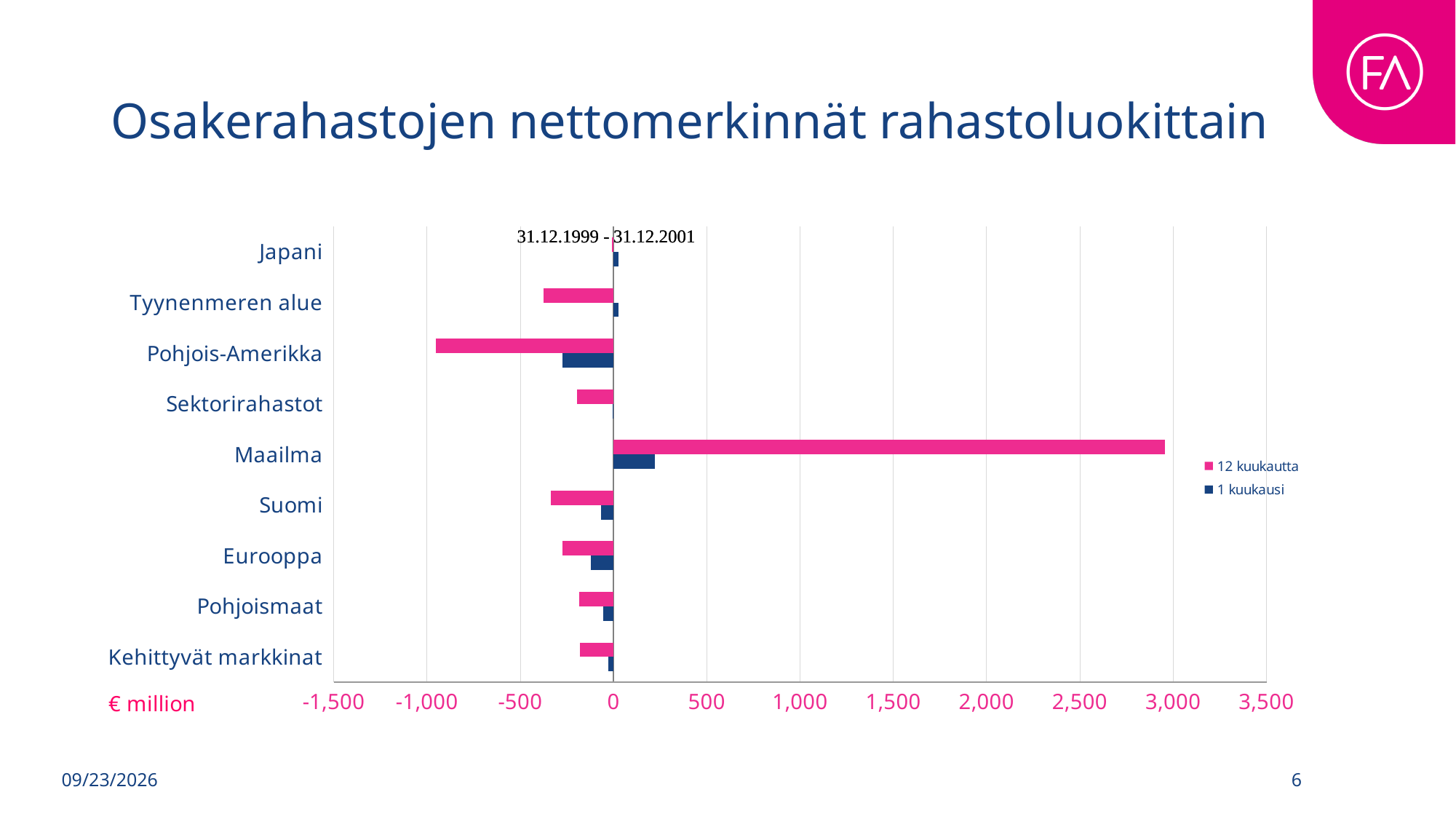
How many fund categories are listed on the vertical axis of the chart? 9 Which category has the lowest value for the 1 kuukausi series? Pohjois-Amerikka Which is larger, the 12 kuukautta value for Maailma or the 12 kuukautta value for Suomi? Maailma What unit is shown for the horizontal axis of the chart? € million Which category has the highest value for the 12 kuukautta series? Maailma What kind of chart is shown on the slide? bar chart Which category has the lowest value for the 12 kuukautta series? Pohjois-Amerikka What is the title of the slide containing the chart? Osakerahastojen nettomerkinnät rahastoluokittain Which category has the highest value for the 1 kuukausi series? Maailma Is the 12 kuukautta value for Maailma greater or less than 2,500? greater Is the 12 kuukautta value for Pohjois-Amerikka greater or less than -500? less How many series does the chart legend list? 2